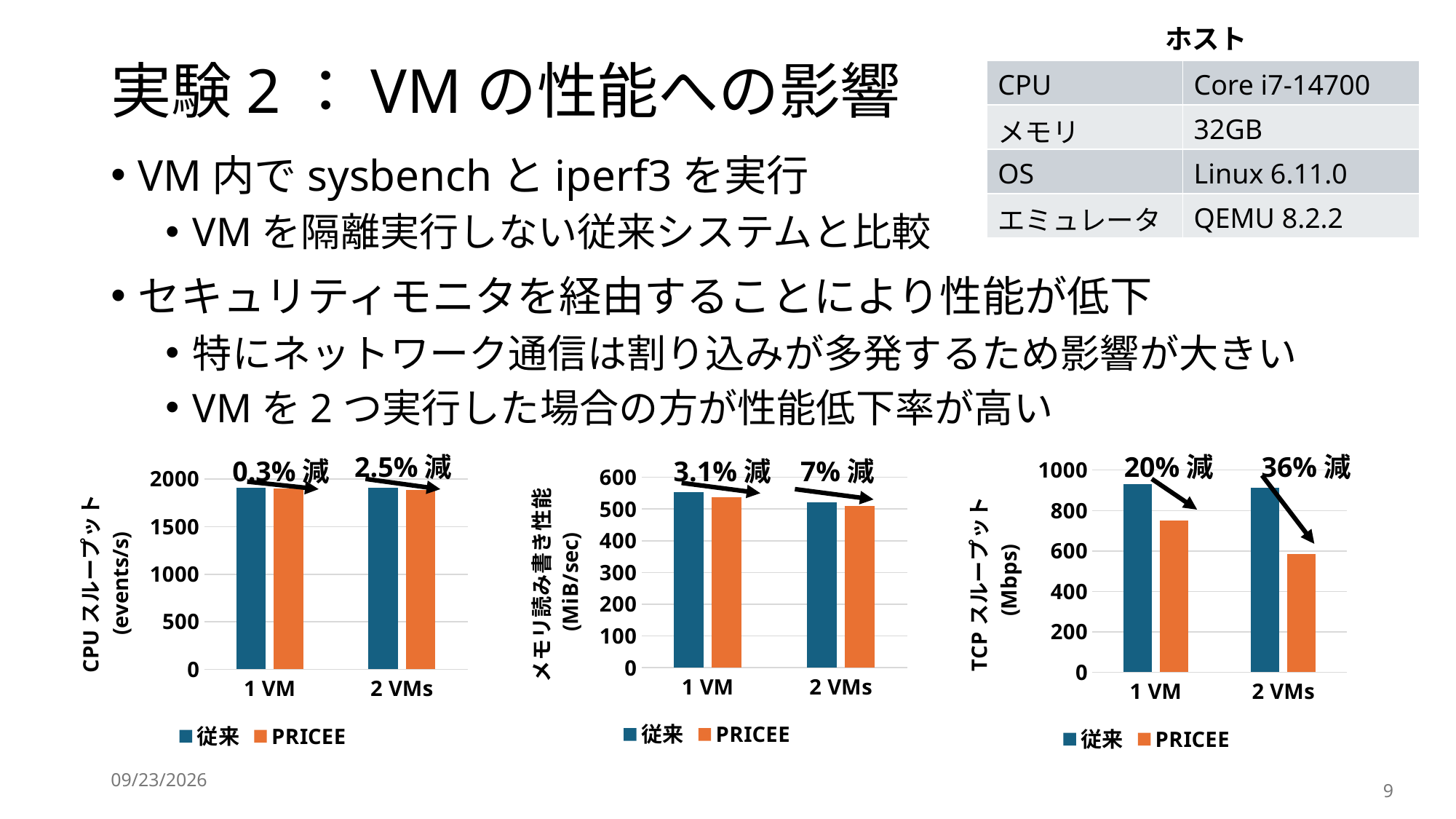
In the rightmost chart (TCP スループット), is the value for PRICEE at 1 VM greater or less than 800? less In the middle chart (メモリ読み書き性能), how many categories are shown on the x axis? 2 In the rightmost chart (TCP スループット), which bar is the lowest? PRICEE at 2 VMs In the rightmost chart (TCP スループット), how many series does the legend list? 2 In the rightmost chart (TCP スループット), is the value for 従来 at 1 VM greater or less than 800? greater What kind of chart is the leftmost chart (CPU スループット)? bar chart In the rightmost chart (TCP スループット), what reduction percentage is annotated for 2 VMs? 36% 減 What is the unit shown on the y axis of the rightmost chart (TCP スループット)? Mbps In the leftmost chart (CPU スループット), is the value for PRICEE at 2 VMs greater or less than 1500? greater In the middle chart (メモリ読み書き性能), what reduction percentage is annotated for 1 VM? 3.1% 減 In the rightmost chart (TCP スループット), which is larger for 2 VMs: 従来 or PRICEE? 従来